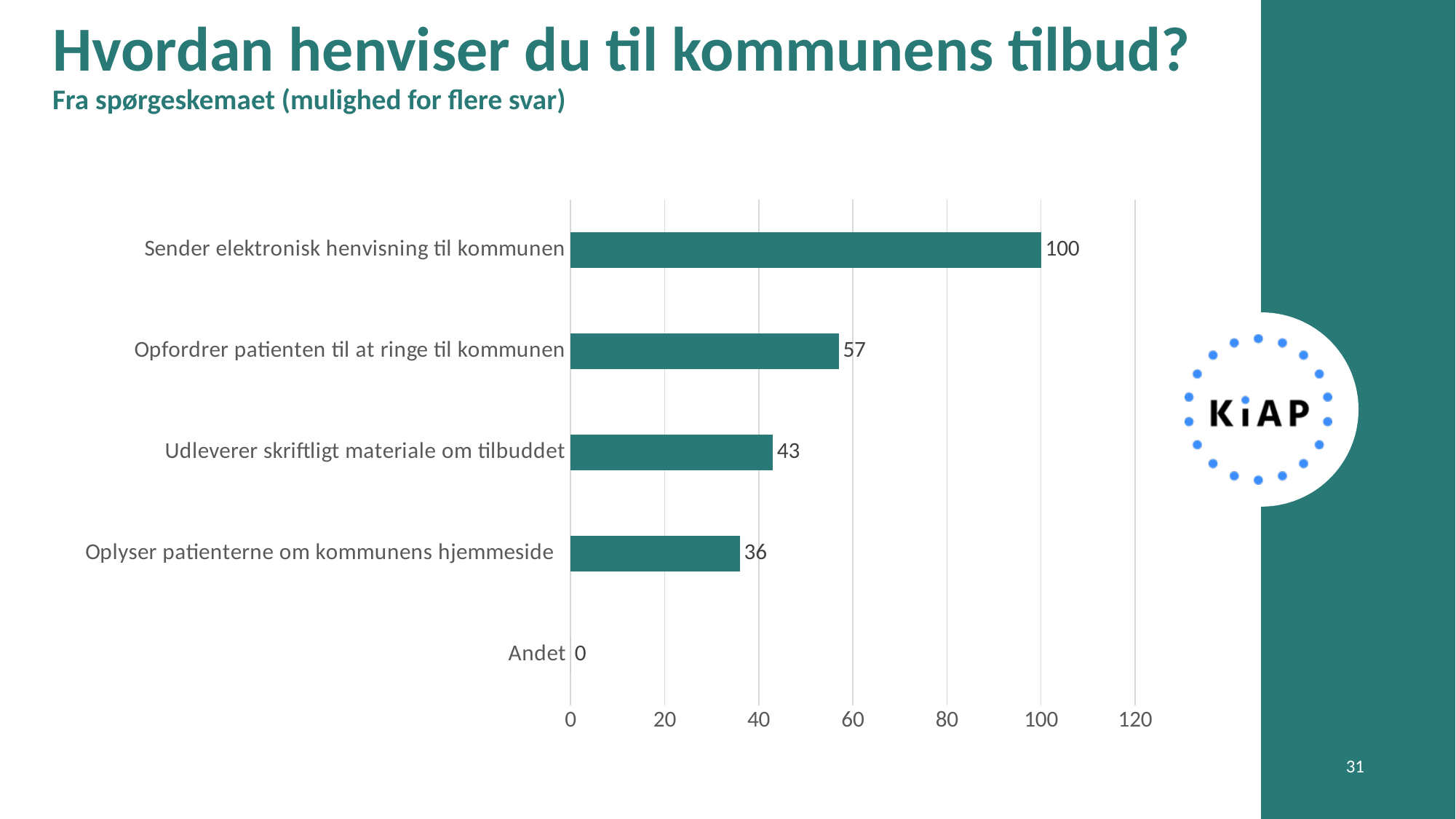
How many categories are shown in the chart? 5 Which category has the highest value? Sender elektronisk henvisning til kommunen What is the value for "Opfordrer patienten til at ringe til kommunen"? 57 What is the value for "Oplyser patienterne om kommunens hjemmeside"? 36 What is the value for "Sender elektronisk henvisning til kommunen"? 100 Which category has the lowest value? Andet What is the difference between the values for "Sender elektronisk henvisning til kommunen" and "Opfordrer patienten til at ringe til kommunen"? 43 What is the value for "Andet"? 0 What is the title of the slide? Hvordan henviser du til kommunens tilbud? Which is larger: the value for "Udleverer skriftligt materiale om tilbuddet" or the value for "Oplyser patienterne om kommunens hjemmeside"? Udleverer skriftligt materiale om tilbuddet What kind of chart is shown on the slide? Bar chart What is the value for "Udleverer skriftligt materiale om tilbuddet"? 43